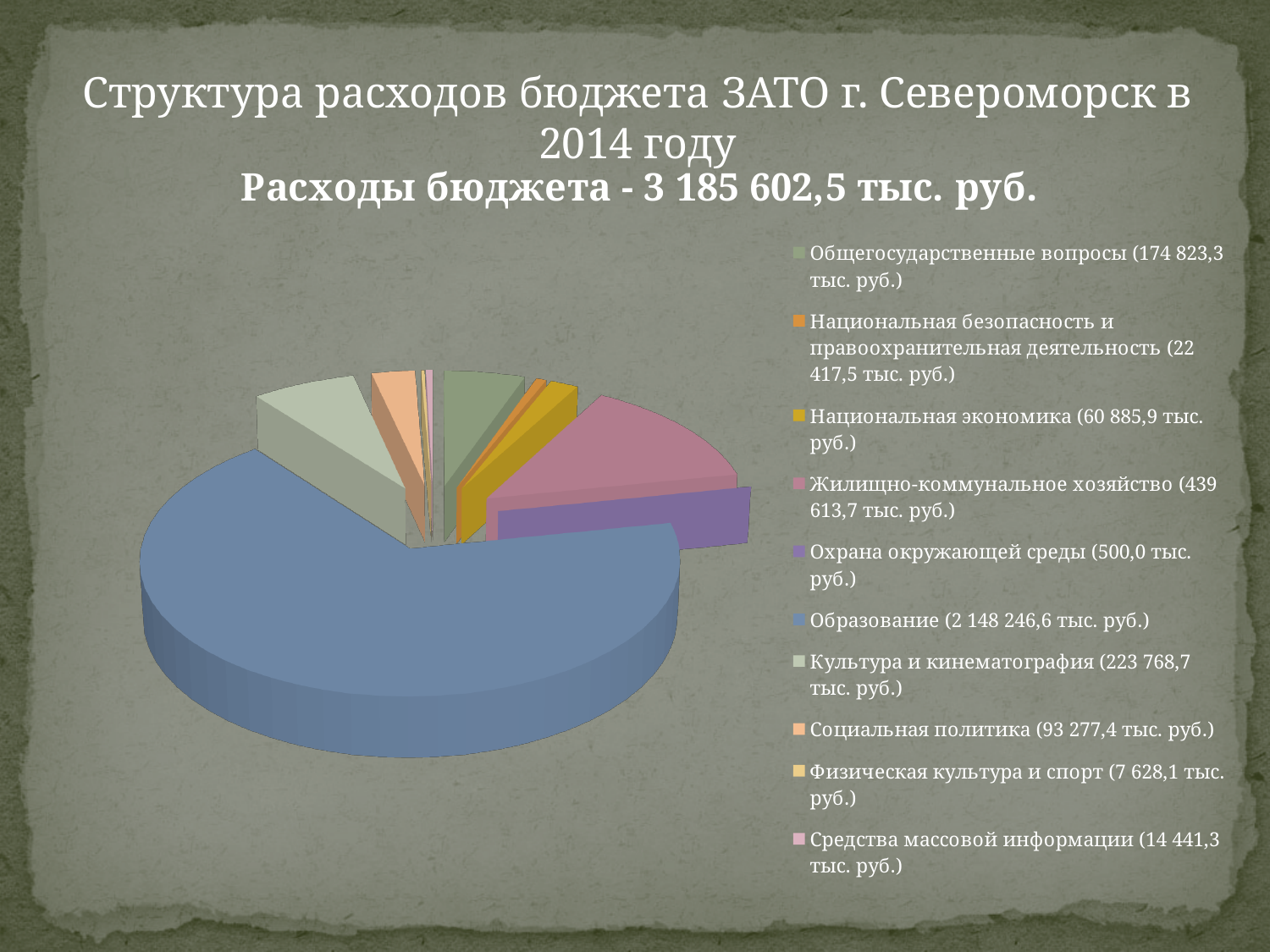
What is the value for Образование? 2 148 246,6 тыс. руб. What is the value for Жилищно-коммунальное хозяйство? 439 613,7 тыс. руб. How many categories does the legend of the pie chart list? 10 What is the value for Социальная политика? 93 277,4 тыс. руб. What is the title of the slide containing the chart? Структура расходов бюджета ЗАТО г. Североморск в 2014 году What kind of chart is shown on the slide? Pie chart Which category has the smallest share of the budget expenditures? Охрана окружающей среды What is the value for Физическая культура и спорт? 7 628,1 тыс. руб. What is the difference between Культура и кинематография and Общегосударственные вопросы? 48 945,4 тыс. руб. What total budget expenditure is stated on the slide? 3 185 602,5 тыс. руб. Which category has the largest share of the budget expenditures? Образование Which is larger: Жилищно-коммунальное хозяйство or Культура и кинематография? Жилищно-коммунальное хозяйство